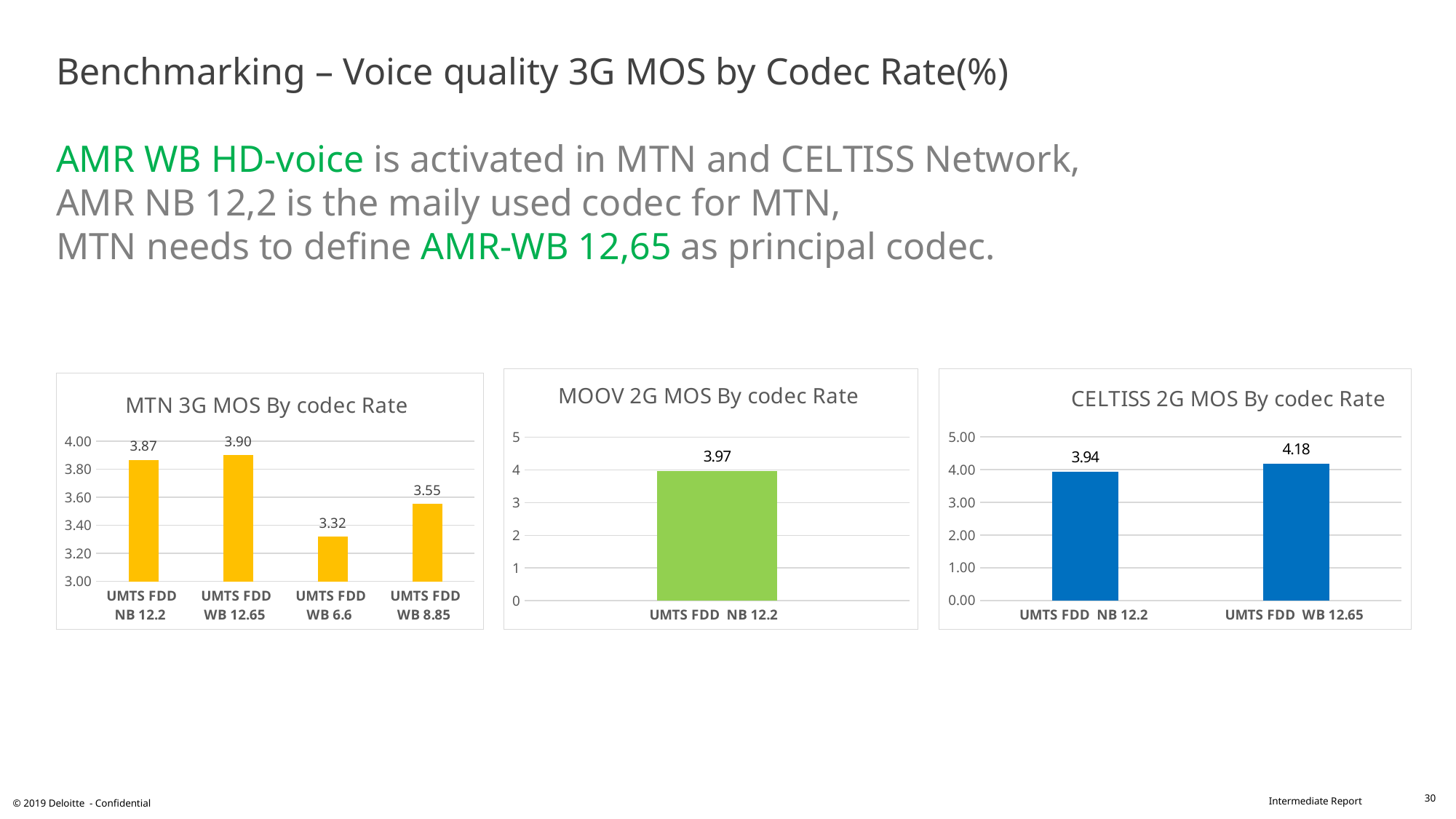
In the 'MOOV 2G MOS By codec Rate' chart, what is the value for UMTS FDD NB 12.2? 3.97 In the 'MTN 3G MOS By codec Rate' chart, is the value for UMTS FDD WB 8.85 greater or less than 3.60? less In the 'MTN 3G MOS By codec Rate' chart, what is the difference between UMTS FDD NB 12.2 and UMTS FDD WB 6.6? 0.55 In the 'MTN 3G MOS By codec Rate' chart, what is the value for UMTS FDD WB 12.65? 3.90 What colour are the bars in the 'CELTISS 2G MOS By codec Rate' chart? blue In the 'CELTISS 2G MOS By codec Rate' chart, what is the value for UMTS FDD WB 12.65? 4.18 What kind of chart is the 'MOOV 2G MOS By codec Rate' chart? bar chart In the 'CELTISS 2G MOS By codec Rate' chart, which is larger, UMTS FDD NB 12.2 or UMTS FDD WB 12.65? UMTS FDD WB 12.65 In the 'MTN 3G MOS By codec Rate' chart, which category has the highest value? UMTS FDD WB 12.65 In the 'MTN 3G MOS By codec Rate' chart, which category has the lowest value? UMTS FDD WB 6.6 In the 'MTN 3G MOS By codec Rate' chart, how many categories are shown? 4 In the 'CELTISS 2G MOS By codec Rate' chart, what is the difference between UMTS FDD WB 12.65 and UMTS FDD NB 12.2? 0.24